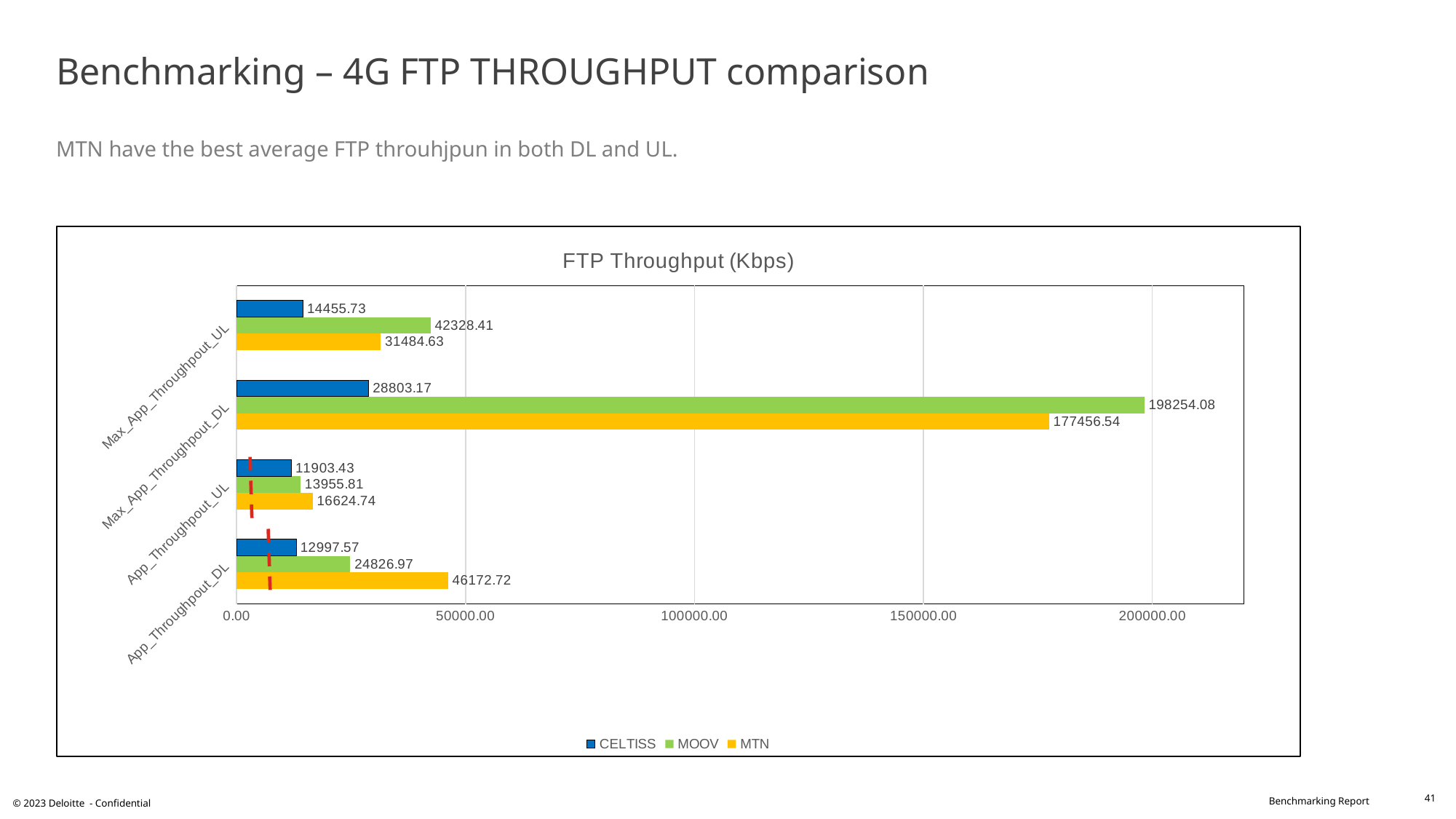
Which series has the highest value for Max_App_Throughpout_UL? MOOV What type of chart is shown on the slide? bar chart What is the CELTISS value for App_Throughpout_UL? 11903.43 How many categories are shown on the vertical axis of the chart? 4 What is the title of the chart? FTP Throughput (Kbps) What is the MTN value for App_Throughpout_DL? 46172.72 Which series has the lowest value for Max_App_Throughpout_DL? CELTISS What is the MOOV value for Max_App_Throughpout_DL? 198254.08 How many series does the legend list? 3 What is the difference between the MOOV and MTN values for Max_App_Throughpout_DL? 20797.54 Is the MTN value for Max_App_Throughpout_DL greater or less than 150000.00? greater Which is larger for App_Throughpout_UL: the MOOV value or the MTN value? MTN